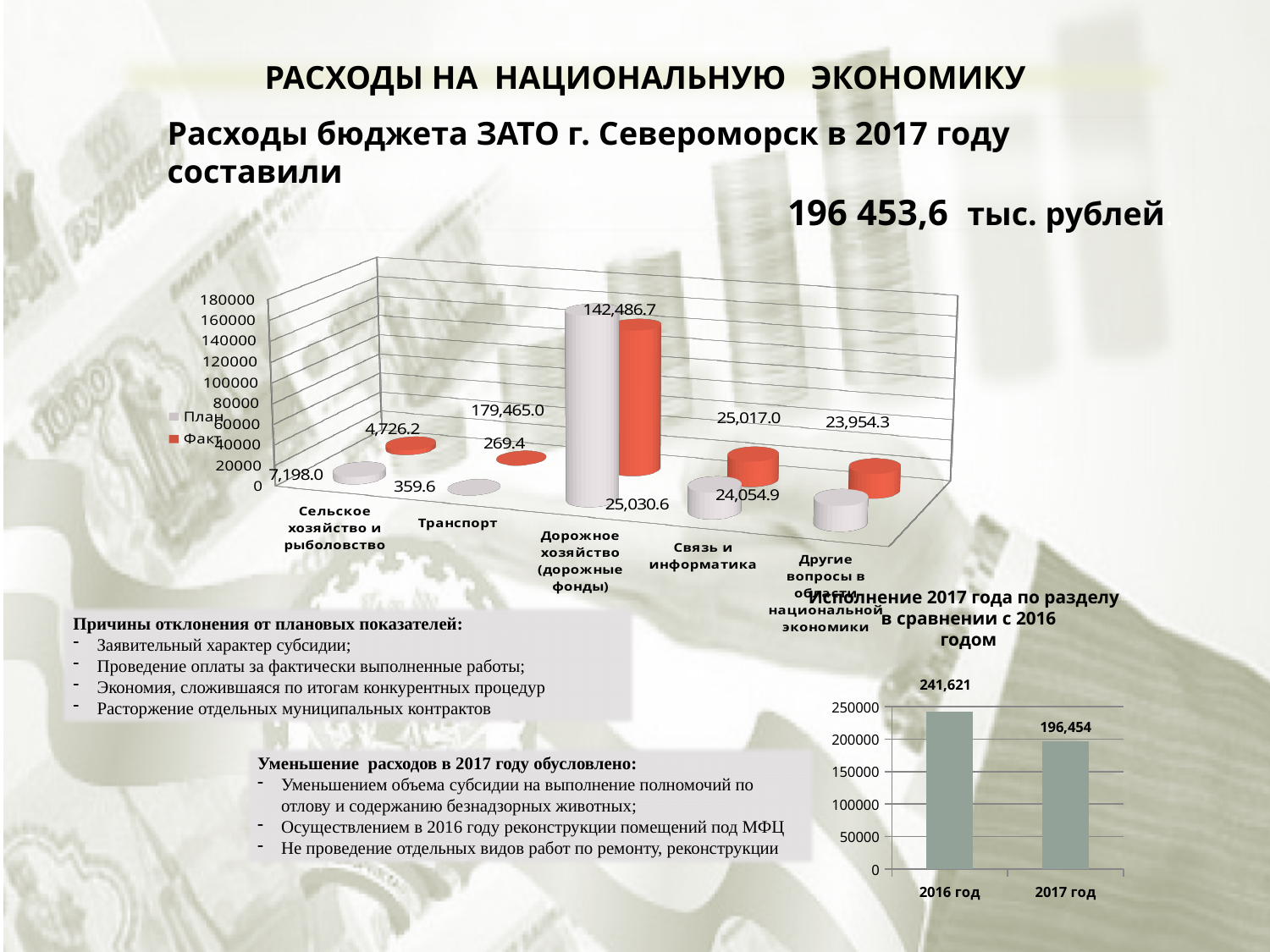
In the large chart with План and Факт series, which category has the lowest Факт value? Транспорт In the small chart titled 'Исполнение 2017 года по разделу в сравнении с 2016 годом', what is the value for 2016 год? 241,621 In the small chart comparing 2016 and 2017, what is the difference between the 2016 and 2017 values? 45,167 In the large chart with План and Факт series, what is the План value for Дорожное хозяйство (дорожные фонды)? 179,465.0 In the large chart with План and Факт series, how many series does the legend list? 2 In the large chart with План and Факт series, how many categories are shown on the x axis? 5 In the small chart comparing 2016 and 2017, do the values rise or fall from 2016 to 2017? fall In the small chart comparing 2016 and 2017, which year has the higher value? 2016 год In the large chart with План and Факт series, what is the Факт value for Дорожное хозяйство (дорожные фонды)? 142,486.7 In the small chart titled 'Исполнение 2017 года по разделу в сравнении с 2016 годом', what is the value for 2017 год? 196,454 In the small chart comparing 2016 and 2017, how many categories are shown on the x axis? 2 In the large chart with План and Факт series, which category has the highest План value? Дорожное хозяйство (дорожные фонды)